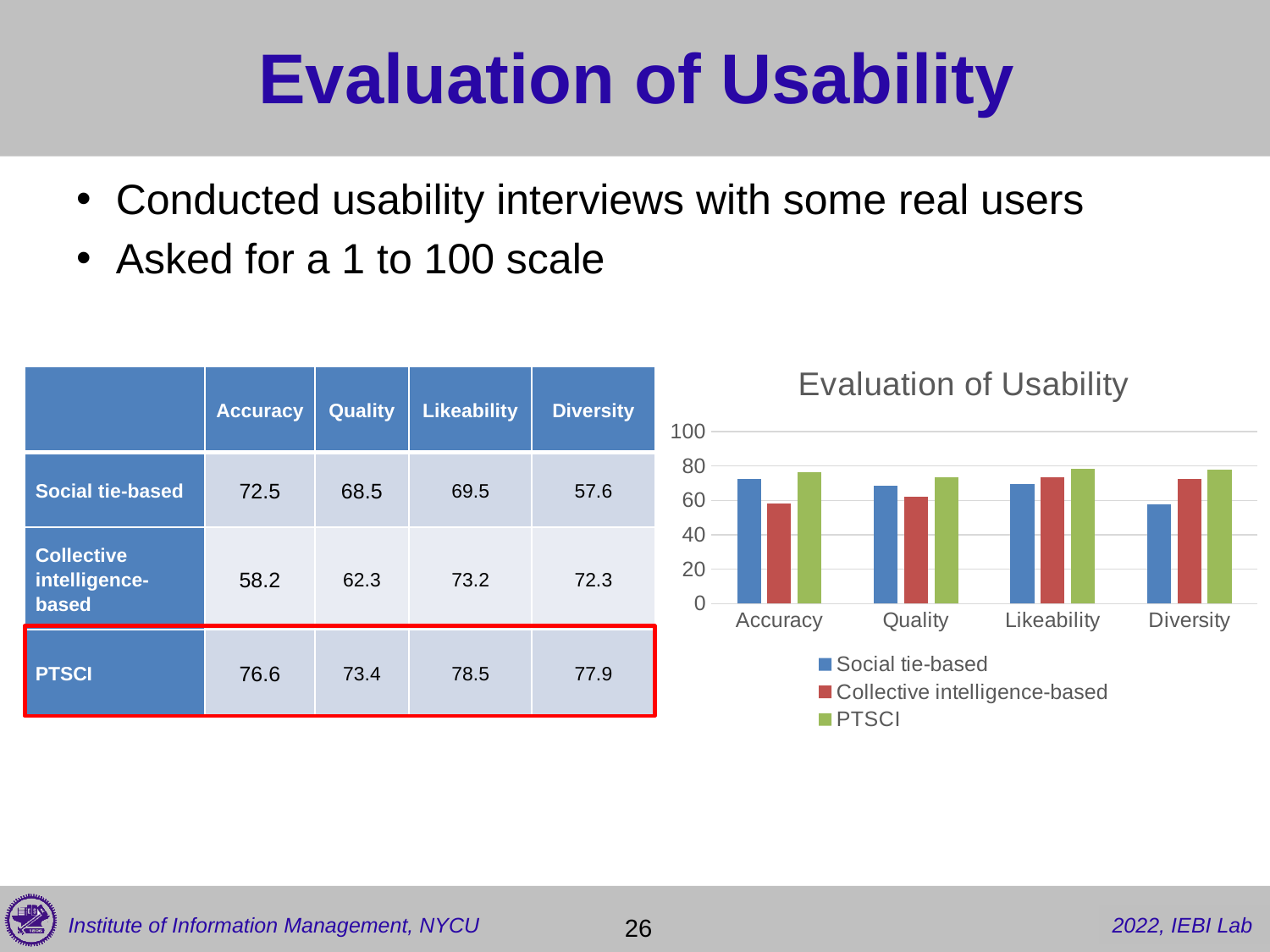
Which series has the highest value for Accuracy? PTSCI What kind of chart is shown on the slide? bar chart Is the PTSCI value for Diversity greater or less than 60? greater What is the difference between the PTSCI and Social tie-based values for Diversity? 20.3 What is the PTSCI value for Likeability? 78.5 How many categories are shown on the x axis of the chart? 4 Which is larger for Quality: the Social tie-based value or the Collective intelligence-based value? Social tie-based Which series has the lowest value for Diversity? Social tie-based Is the Collective intelligence-based value for Accuracy greater or less than 60? less What is the title of the chart? Evaluation of Usability How many series does the chart legend list? 3 What is the Social tie-based value for Diversity? 57.6